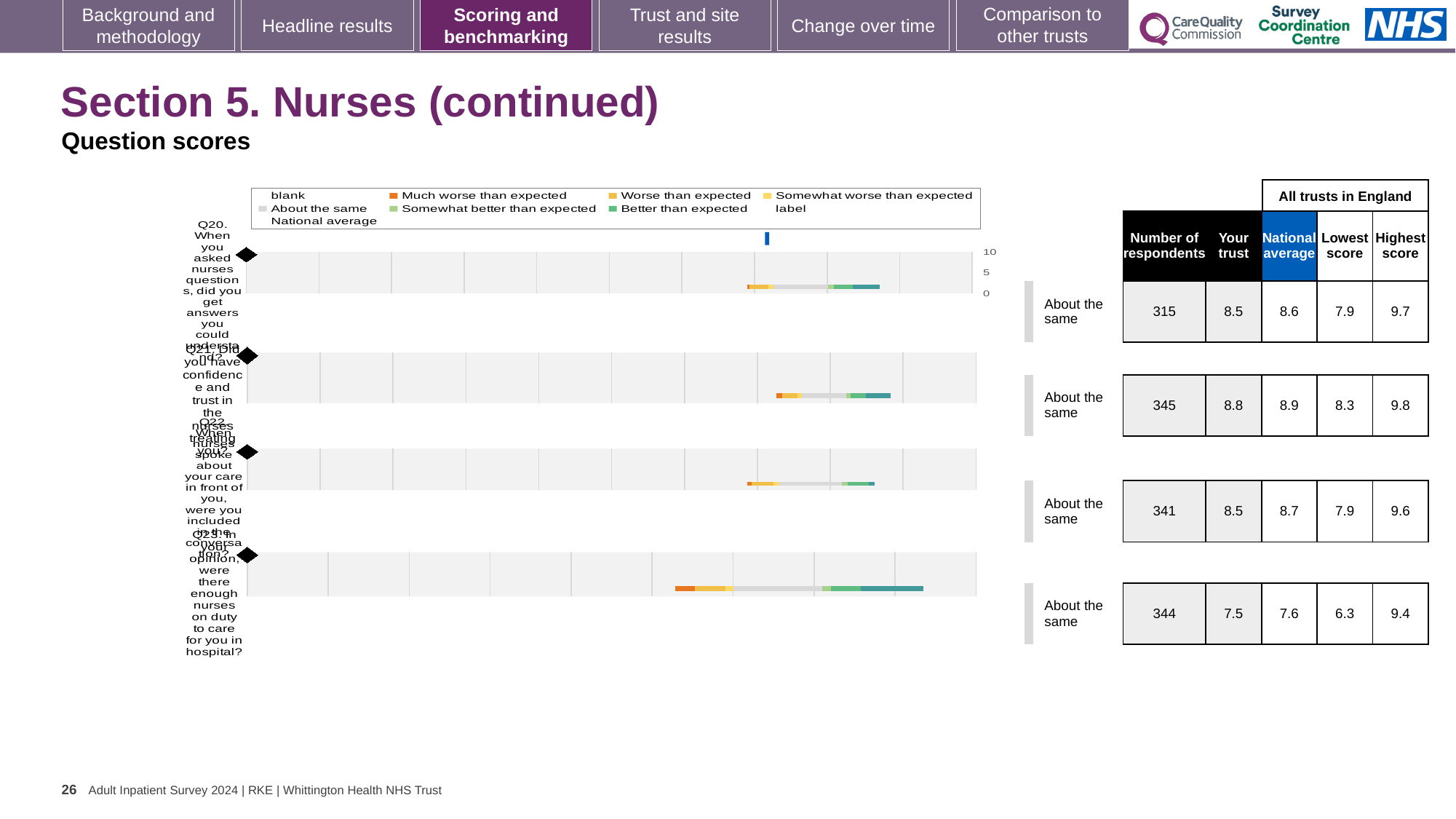
What is the highest tick value shown on the chart's axis? 10 Which question has the highest 'Your trust' score in the table beside the chart? Q21 In the table beside the chart, how many respondents answered Q21? 345 What kind of chart is shown on the slide? bar chart What benchmark category is shown for all four questions next to the chart? About the same What colour does the legend use for 'Much worse than expected'? orange In the table beside the chart, what is the national average for Q23? 7.6 In the table beside the chart, what is the 'Your trust' score for Q20? 8.5 For Q23, what is the difference between the highest score and the lowest score across all trusts in England? 3.1 For Q20, which is larger: the 'Your trust' score or the national average? national average How many questions (bars) are plotted in the chart? 4 Which question has the lowest 'Your trust' score in the table beside the chart? Q23